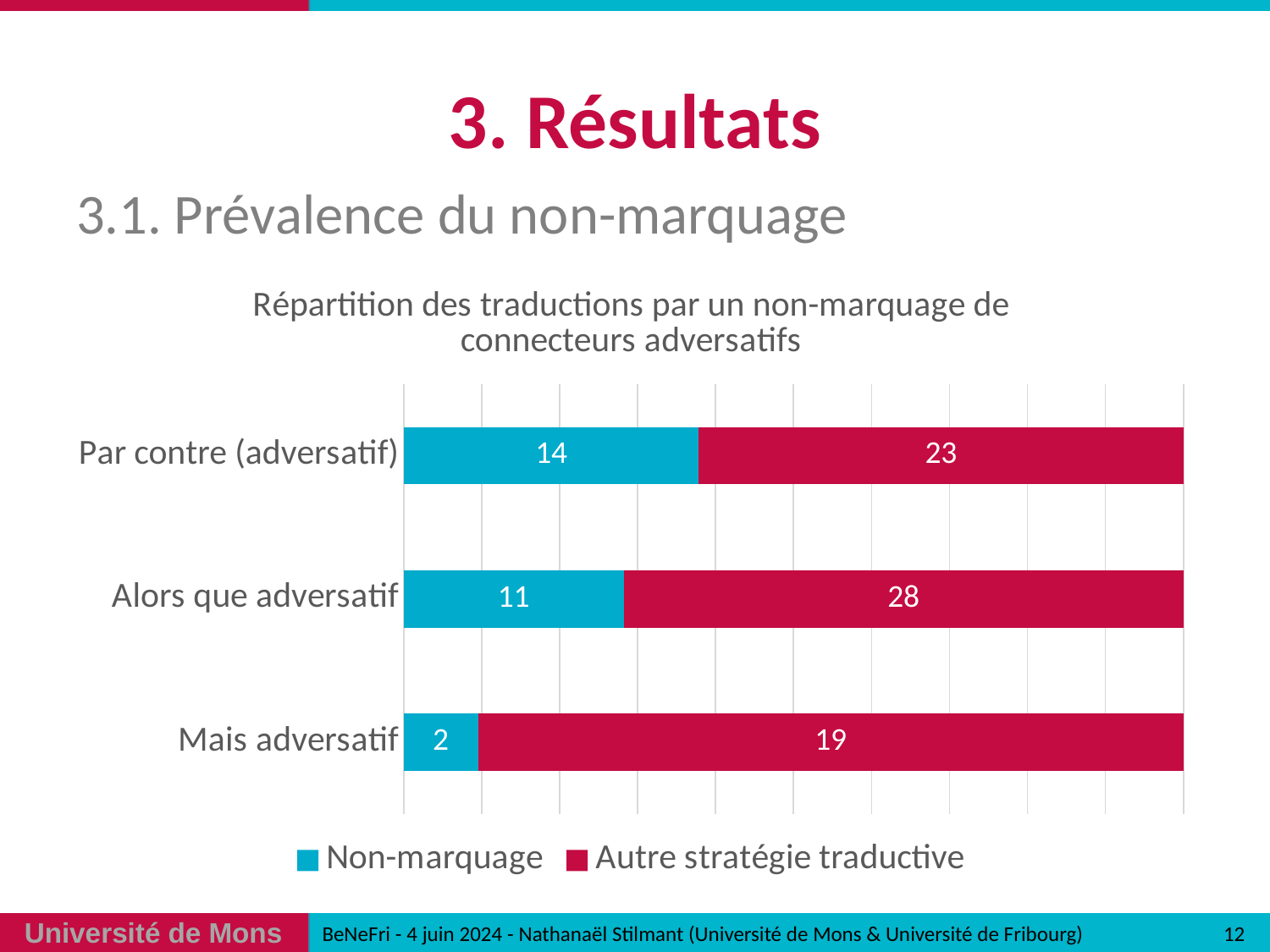
What is the Non-marquage value for Par contre (adversatif)? 14 What is the difference between the Autre stratégie traductive and Non-marquage values for Alors que adversatif? 17 How many categories are shown on the chart? 3 What is the total of the stacked bar for Par contre (adversatif)? 37 Which category has the highest Non-marquage value? Par contre (adversatif) What is the Autre stratégie traductive value for Alors que adversatif? 28 What is the Non-marquage value for Mais adversatif? 2 Which is larger: the Non-marquage value for Par contre (adversatif) or for Alors que adversatif? Par contre (adversatif) How many series does the legend list? 2 What is the Autre stratégie traductive value for Mais adversatif? 19 What kind of chart is shown on the slide? Stacked bar chart Which category has the lowest Autre stratégie traductive value? Mais adversatif